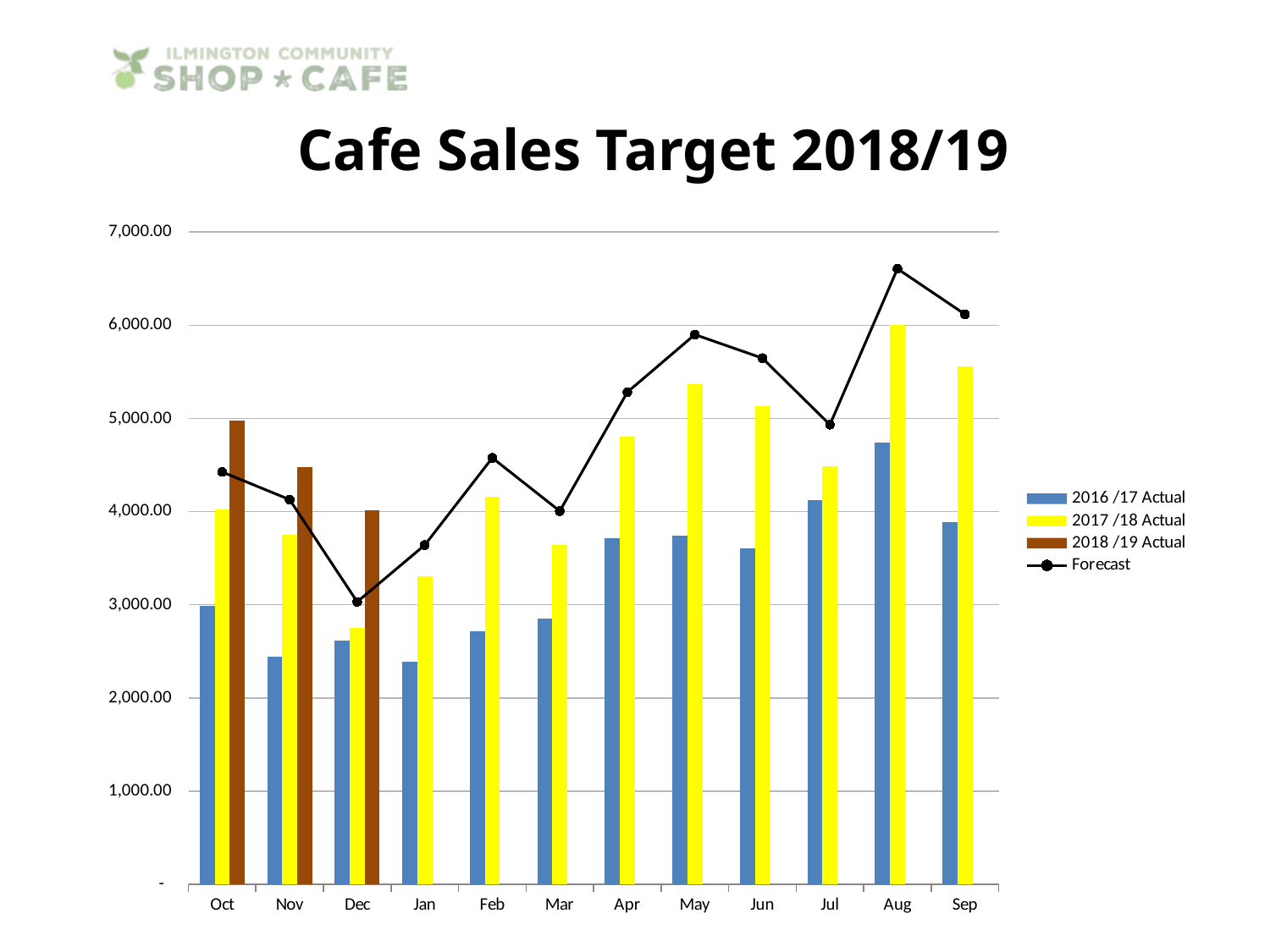
In which month is the Forecast value highest? Aug In which month is the 2017 /18 Actual value lowest? Dec In which month is the Forecast value lowest? Dec What is the title of the chart? Cafe Sales Target 2018/19 In Oct, which is larger: the 2018 /19 Actual value or the 2017 /18 Actual value? 2018 /19 Actual What kind of chart is shown on the slide? Bar chart with a line series Is the 2018 /19 Actual value for Nov greater or less than 4,000.00? greater How many months are shown on the x axis of the chart? 12 How many series does the chart legend list? 4 In which month is the 2017 /18 Actual value highest? Aug Which series is drawn as a line with markers rather than bars? Forecast Is the 2017 /18 Actual value for May greater or less than 5,000.00? greater